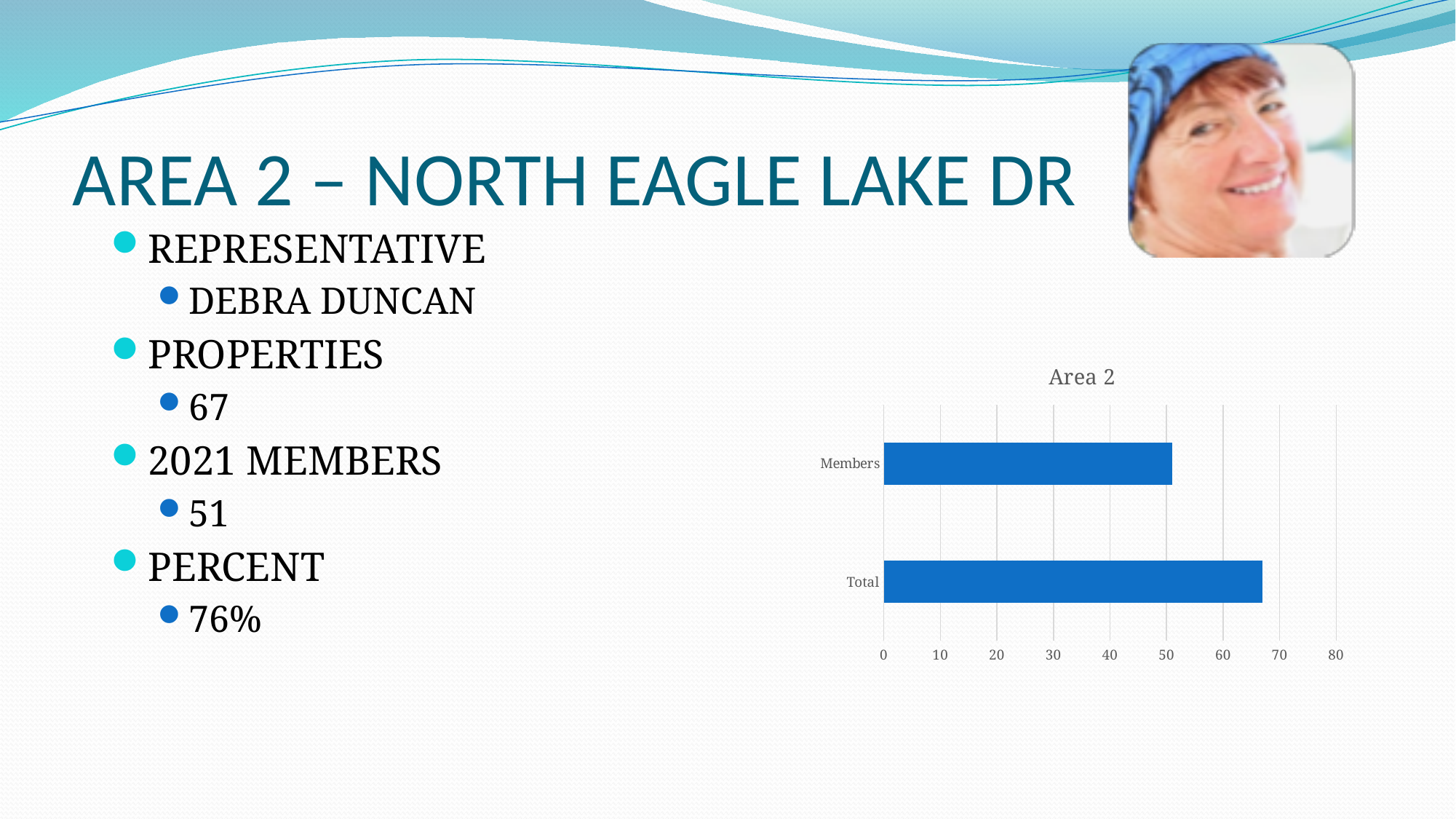
Which is larger in the chart, the value for Members or the value for Total? Total Is the value for Total greater or less than 70? less Is the value for Members greater or less than 40? greater Which category has the lowest value in the chart? Members What kind of chart is shown on the slide? bar chart How many categories does the chart show? 2 Is the value for Total greater or less than 60? greater Which category has the highest value in the chart? Total What is the highest tick value shown on the chart's value axis? 80 What is the title of the chart? Area 2